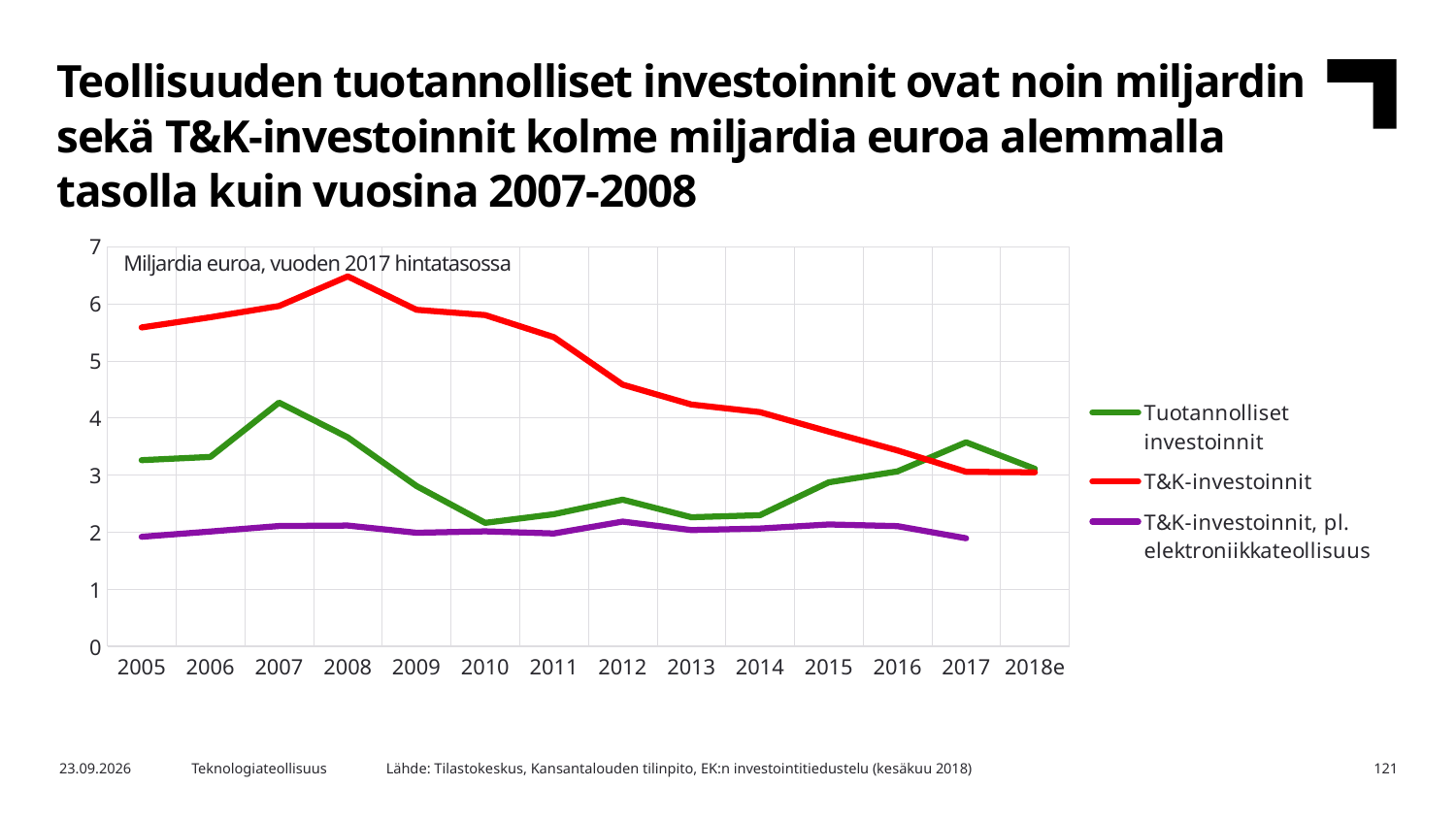
How many years are shown on the x axis? 14 In which year does the T&K-investoinnit line reach its highest value? 2008 Is the value for T&K-investoinnit in 2012 greater or less than 5? less Which is larger in 2017: Tuotannolliset investoinnit or T&K-investoinnit? Tuotannolliset investoinnit Does the T&K-investoinnit line rise or fall from 2008 to 2017? fall Is the value for T&K-investoinnit in 2008 greater or less than 6? greater What kind of chart is shown on the slide? line chart Is the value for Tuotannolliset investoinnit in 2010 greater or less than 3? less What unit is stated in the text box inside the chart? Miljardia euroa, vuoden 2017 hintatasossa In which year does the Tuotannolliset investoinnit line reach its highest value? 2007 How many series does the legend list? 3 Which is larger in 2005: T&K-investoinnit or Tuotannolliset investoinnit? T&K-investoinnit